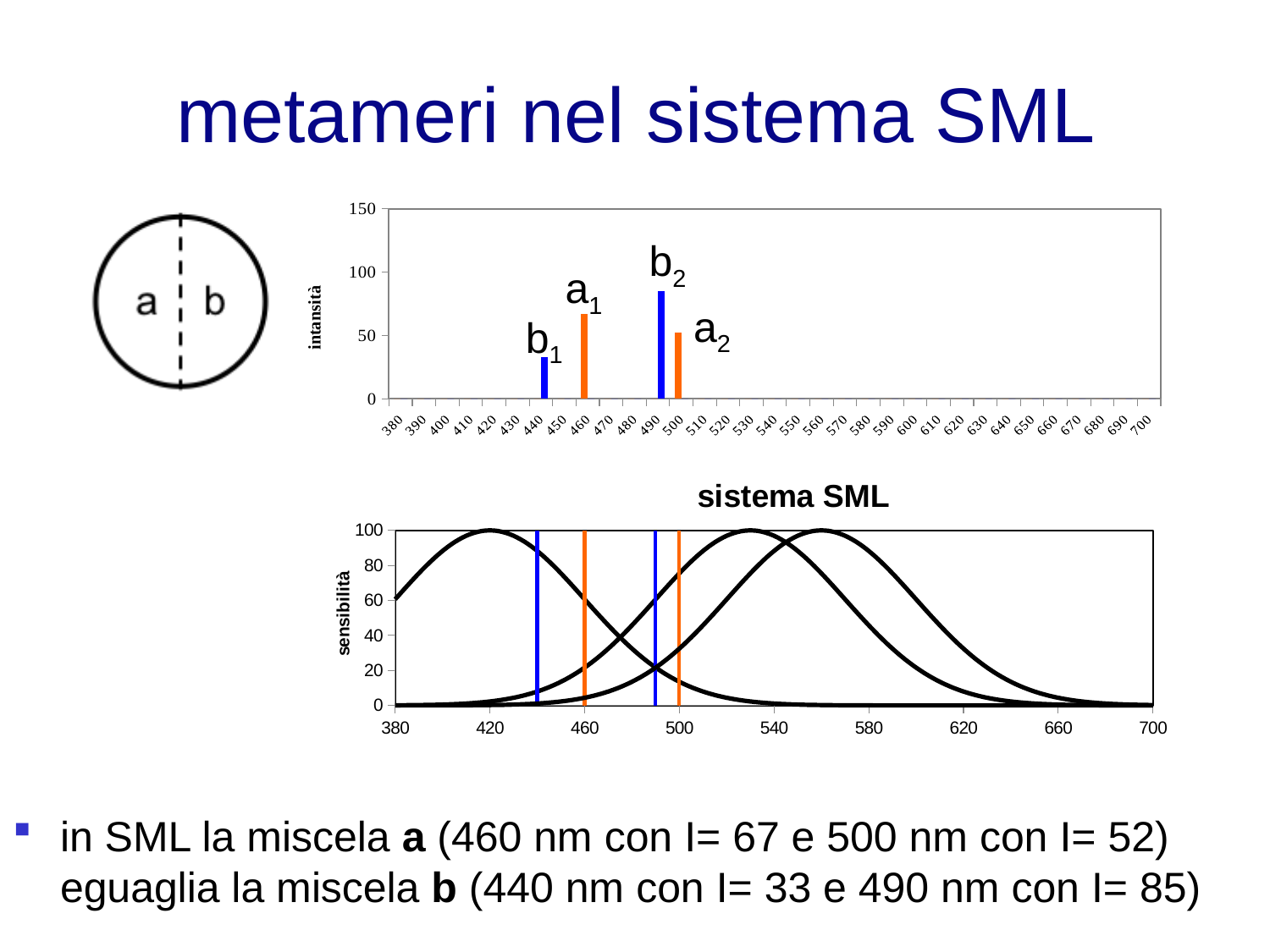
In the top chart, what is the intensity of bar b2? 85 In the top chart, what is the intensity of bar b1? 33 In the top chart, which bar is the shortest? b1 How many bars are plotted in the top chart? 4 What is the title of the bottom chart? sistema SML In the top chart, what is the difference in intensity between a1 and a2? 15 How many sensitivity curves are drawn in the bottom chart 'sistema SML'? 3 In the top chart, what is the intensity of bar a1? 67 What kind of chart is the top chart (intensity vs wavelength)? bar chart In the top chart, which is larger, a1 or b1? a1 In the top chart, is the value for a2 greater or less than 100? less In the top chart, which bar is the tallest? b2